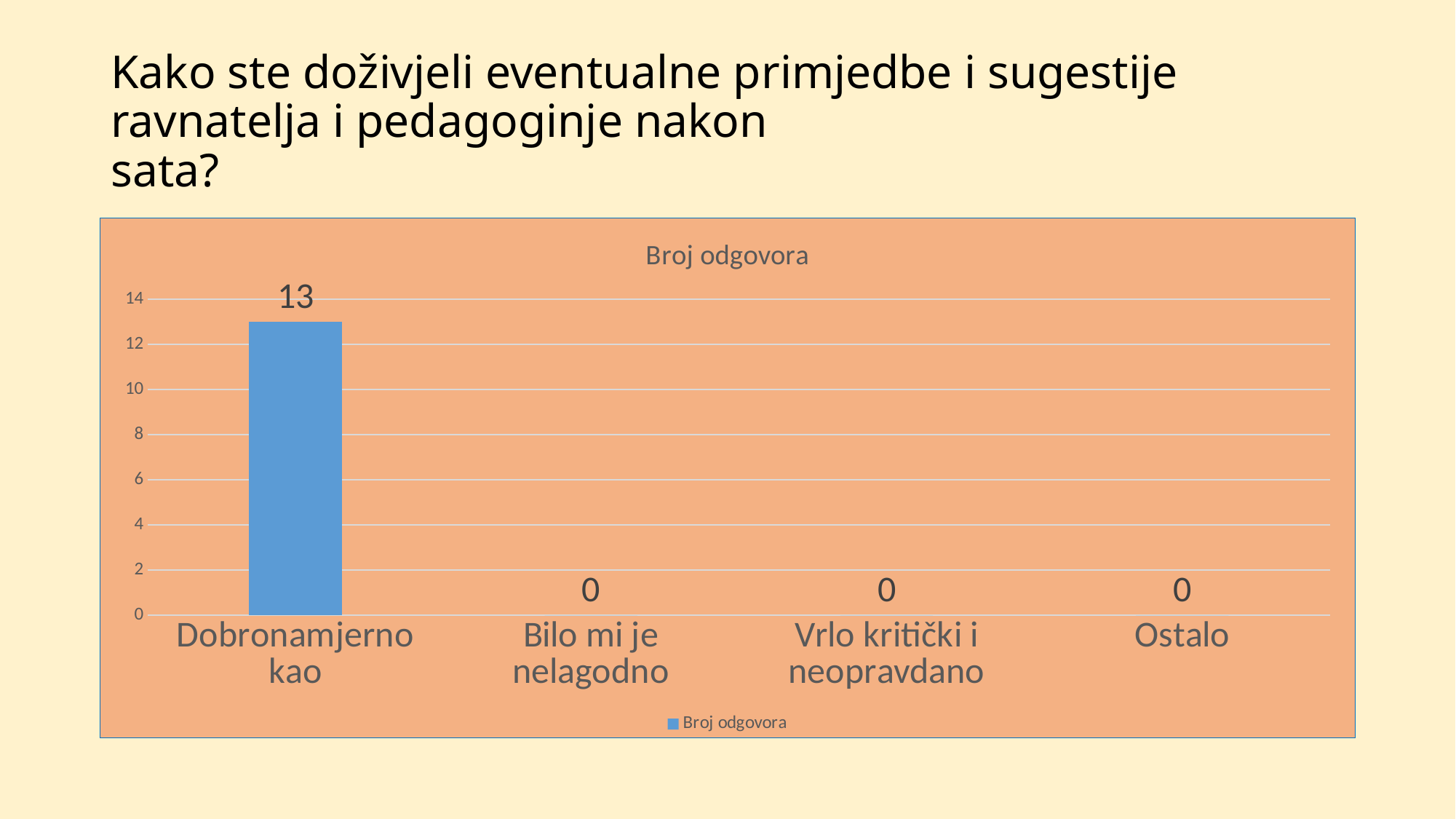
Which category has the highest value? Dobronamjerno kao What is the title of the chart? Broj odgovora Is the value for "Dobronamjerno kao" greater or less than 10? greater What is the value for "Bilo mi je nelagodno"? 0 What is the difference between the values for "Dobronamjerno kao" and "Ostalo"? 13 How many series does the legend list? 1 What is the value for "Ostalo"? 0 What kind of chart is shown? bar chart How many categories are shown on the x axis? 4 What is the value for "Dobronamjerno kao"? 13 What is the value for "Vrlo kritički i neopravdano"? 0 Which is larger, the value for "Dobronamjerno kao" or the value for "Bilo mi je nelagodno"? Dobronamjerno kao